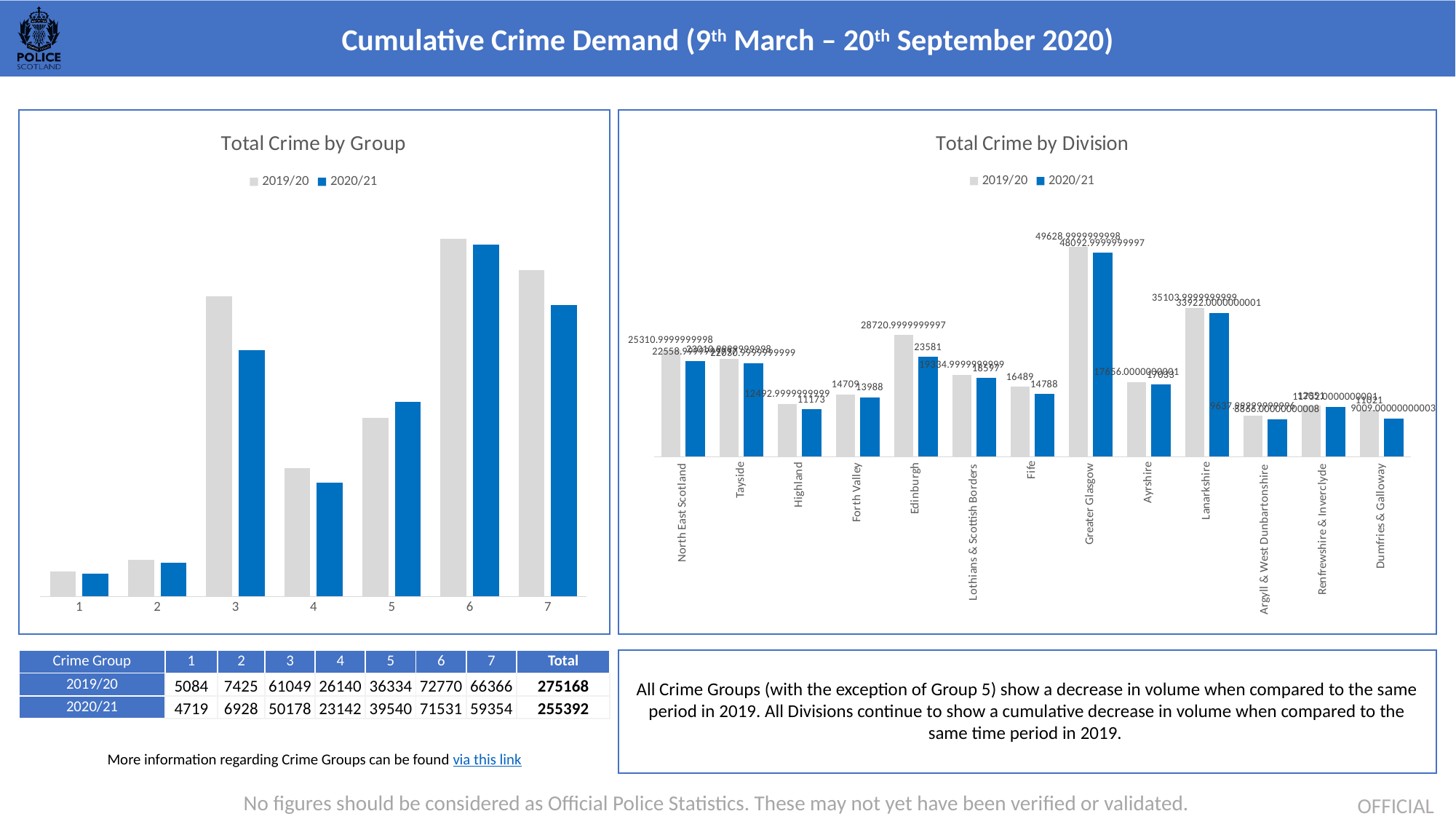
How many crime groups are shown on the x axis of the 'Total Crime by Group' chart? 7 In the 'Total Crime by Group' chart, which crime group has the highest 2019/20 bar? 6 In the 'Total Crime by Group' chart, which crime group has the lowest 2020/21 bar? 1 In the 'Total Crime by Division' chart, what is the difference between the 2019/20 and 2020/21 values for Fife? 1701 What kind of chart is the 'Total Crime by Group' chart? bar chart In the 'Total Crime by Division' chart, what is the 2020/21 value for Edinburgh? 23581 In the 'Total Crime by Division' chart, what is the 2019/20 value for Fife? 16489 In the 'Total Crime by Group' chart, which has the larger 2020/21 bar, group 3 or group 7? group 7 How many divisions are shown on the x axis of the 'Total Crime by Division' chart? 13 In the 'Total Crime by Division' chart, which division has the highest bars? Greater Glasgow How many series does the legend of the 'Total Crime by Group' chart list? 2 In the 'Total Crime by Division' chart, what is the 2020/21 value for Forth Valley? 13988